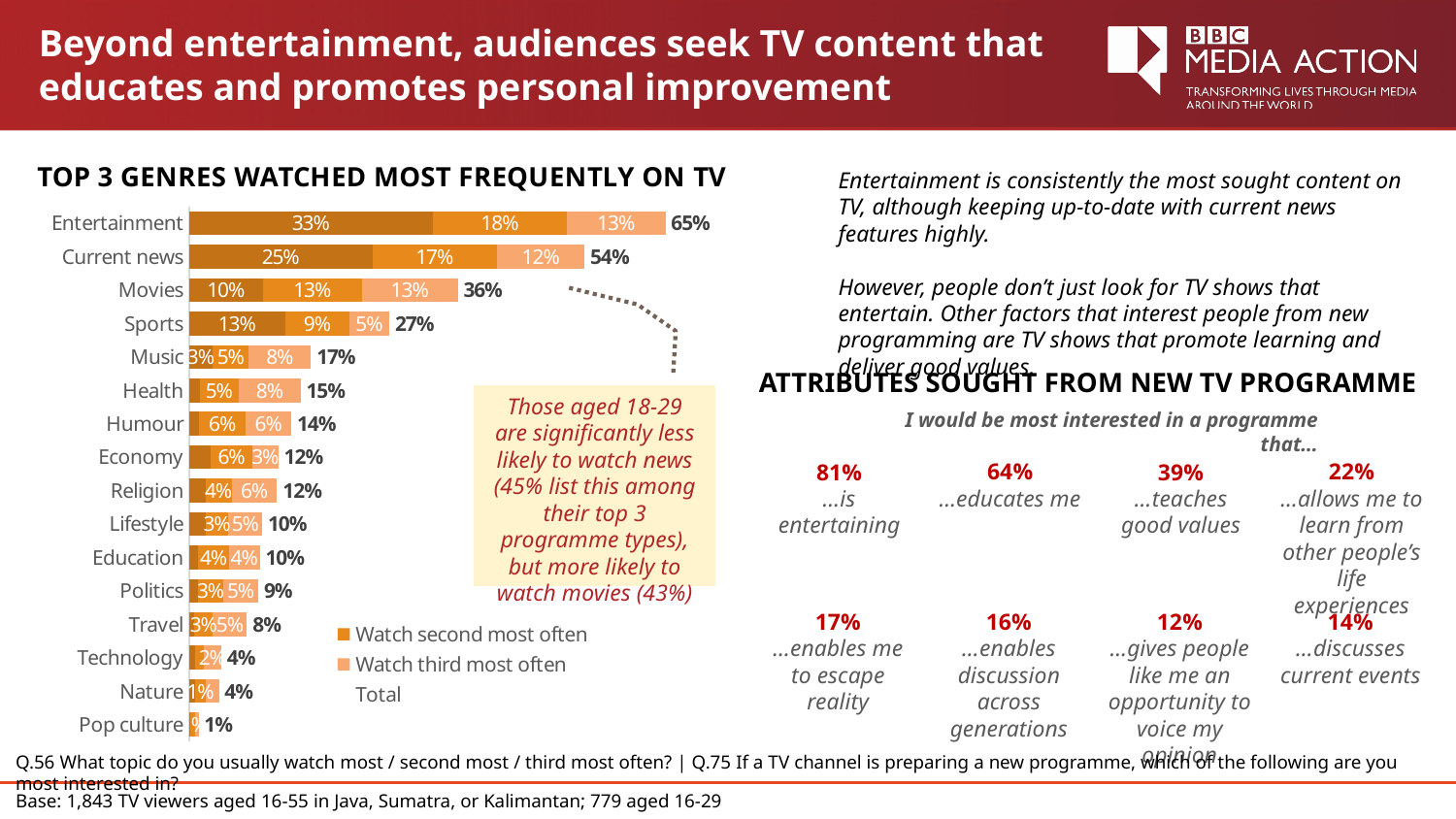
What is the total percentage shown for Current news? 54% What percentage of viewers watch Entertainment most often (the first segment of the Entertainment bar)? 33% What is the difference between the totals for Entertainment and Current news? 11 percentage points Which genre has the lowest total in the chart? Pop culture How many genres are listed in the chart? 16 What percentage is shown for the 'Watch second most often' segment of the Current news bar? 17% What is the title of the chart on the left of the slide? TOP 3 GENRES WATCHED MOST FREQUENTLY ON TV Which genre has the highest total in the chart? Entertainment What type of chart is used to show the top 3 genres watched most frequently on TV? Stacked bar chart What is the total percentage shown for Sports? 27% What is the total percentage shown for Entertainment in the 'Top 3 genres watched most frequently on TV' chart? 65% Which has a higher total, Movies or Sports? Movies